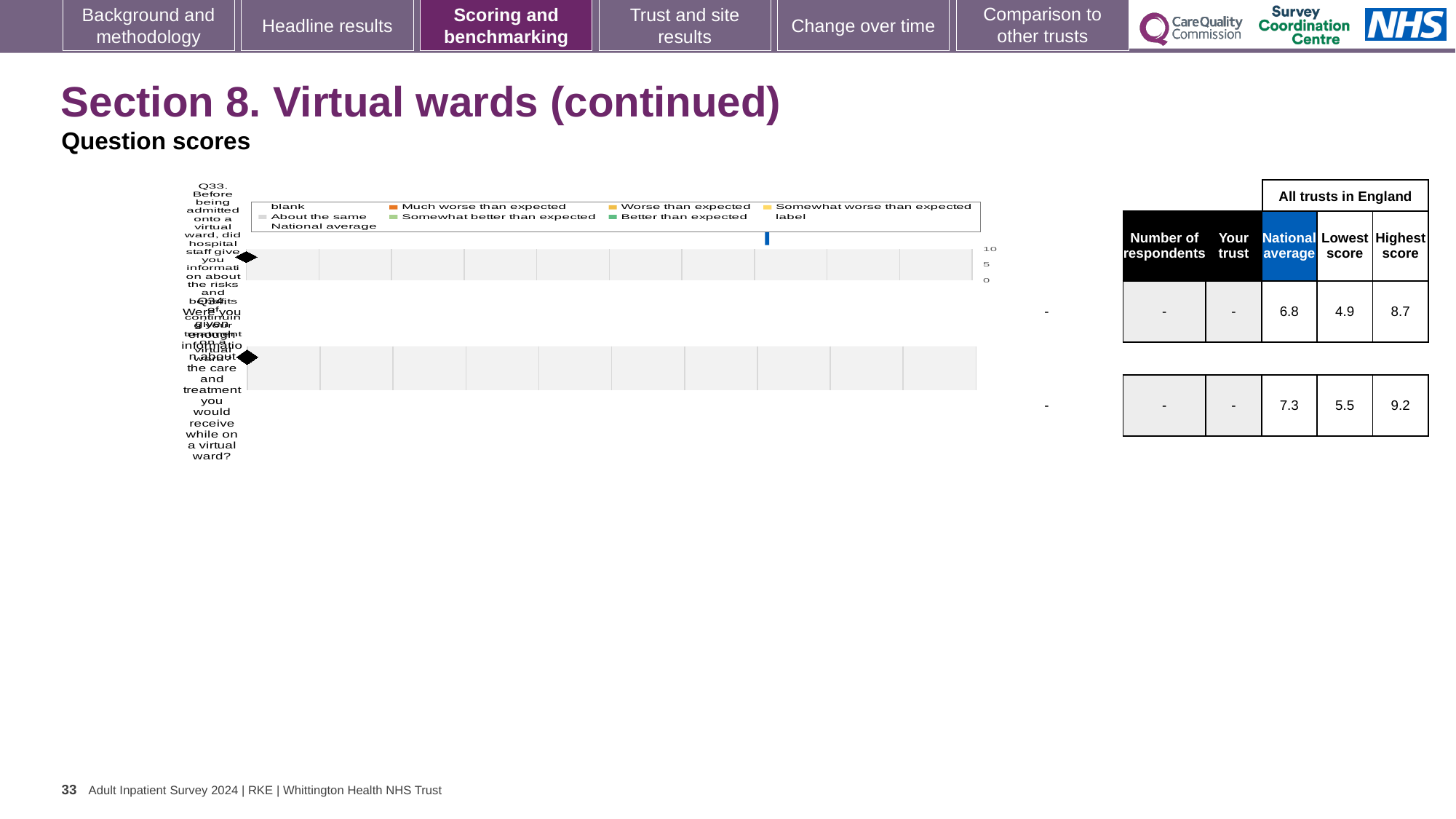
In the table beside the chart, what is the difference between the national averages of Q34 and Q33? 0.5 In the table beside the chart, what is the highest score for Q34? 9.2 In the table beside the chart, what is the difference between the highest and lowest score for Q34? 3.7 What kind of chart is shown on the slide? bar chart In the table beside the chart, which question has the higher national average, Q33 or Q34? Q34 What is the maximum value shown on the chart's axis? 10 How many entries does the chart's legend list? 9 How many question categories (rows) does the chart show? 2 In the table beside the chart, what is the lowest score for Q33? 4.9 In the table beside the chart, what is the national average score for Q33? 6.8